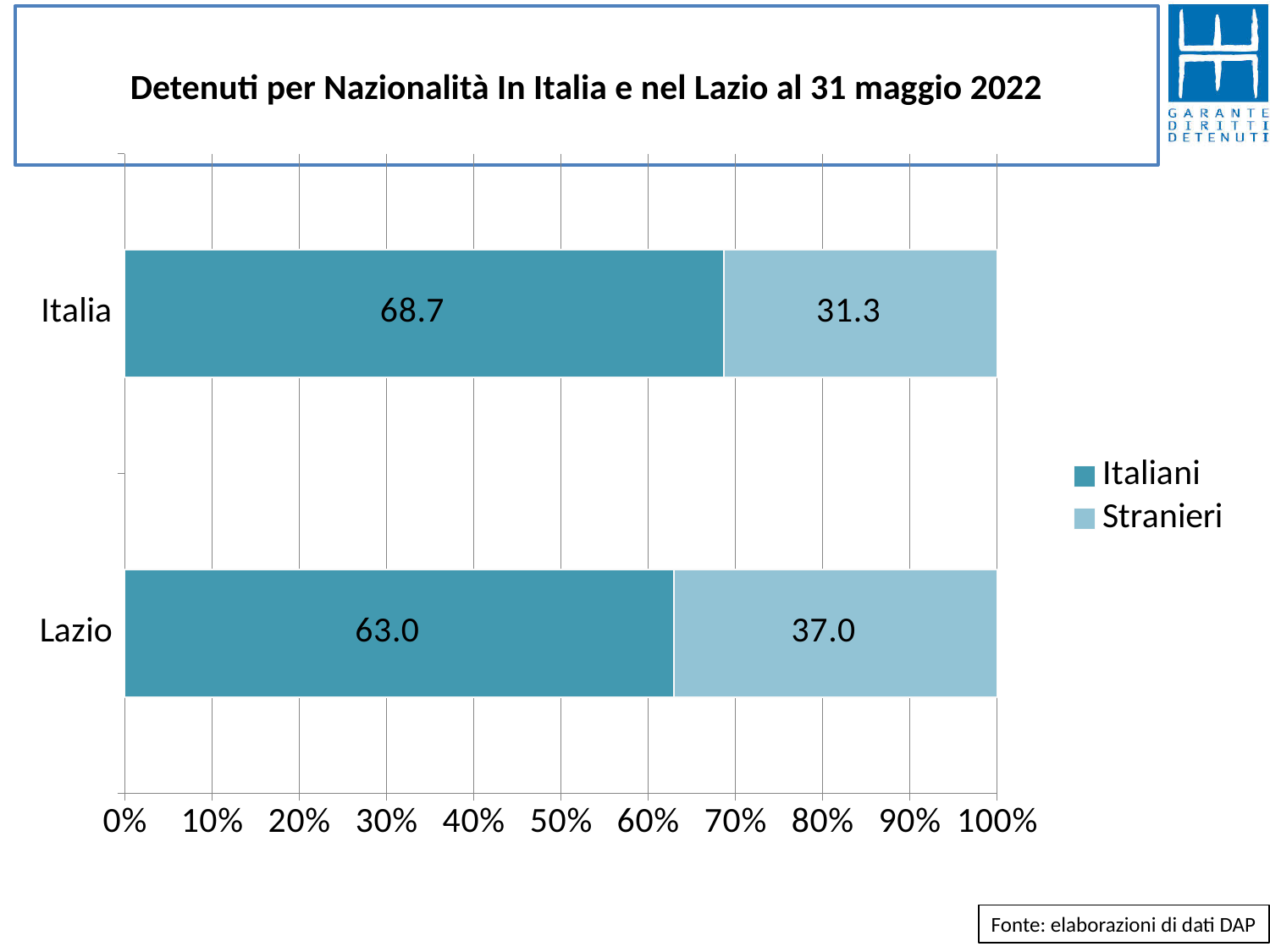
What is the value for Italiani in Italia? 68.7 What is the value for Stranieri in Lazio? 37.0 Which category has the lowest Italiani value? Lazio What is the title of the chart? Detenuti per Nazionalità In Italia e nel Lazio al 31 maggio 2022 What kind of chart is shown on the slide? Stacked bar chart What is the difference between the Stranieri values for Lazio and Italia? 5.7 What is the value for Italiani in Lazio? 63.0 What is the value for Stranieri in Italia? 31.3 How many categories are shown on the chart? 2 Which category has the higher Stranieri value, Italia or Lazio? Lazio How many series does the legend list? 2 What is the difference between the Italiani values for Italia and Lazio? 5.7